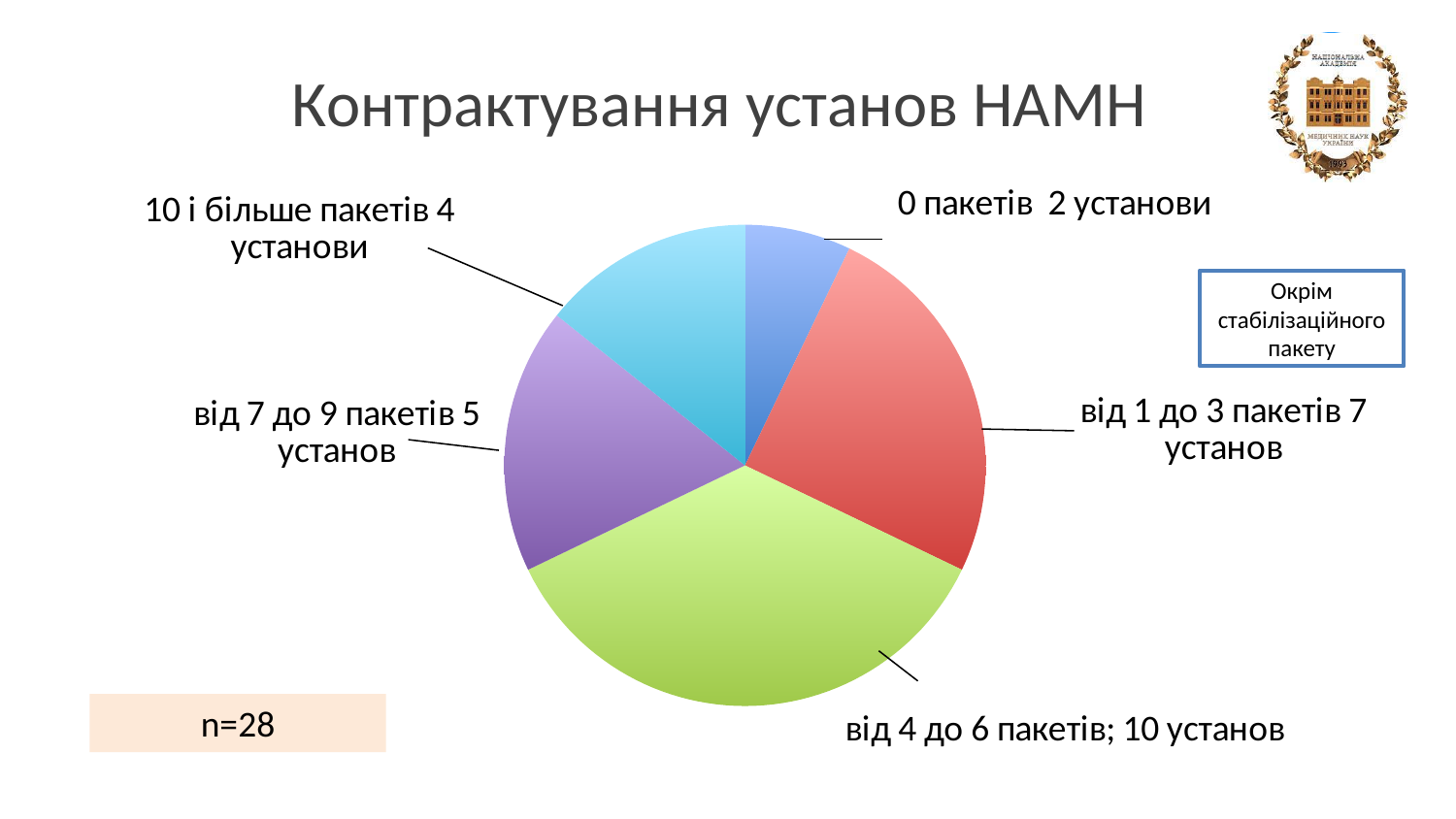
Which category has the largest slice of the pie? від 4 до 6 пакетів How many institutions are in the "10 і більше пакетів" slice? 4 установи What is the title of the chart? Контрактування установ НАМН Which has more institutions: "від 7 до 9 пакетів" or "10 і більше пакетів"? від 7 до 9 пакетів What kind of chart is shown on the slide? pie chart How many institutions are in the "від 4 до 6 пакетів" slice? 10 установ How many institutions are in the "0 пакетів" slice? 2 установи How many slices does the pie chart have? 5 Which category has the smallest slice of the pie? 0 пакетів What is the difference in the number of institutions between "від 4 до 6 пакетів" and "від 1 до 3 пакетів"? 3 How many institutions are in the "від 7 до 9 пакетів" slice? 5 установ How many institutions are in the "від 1 до 3 пакетів" slice? 7 установ